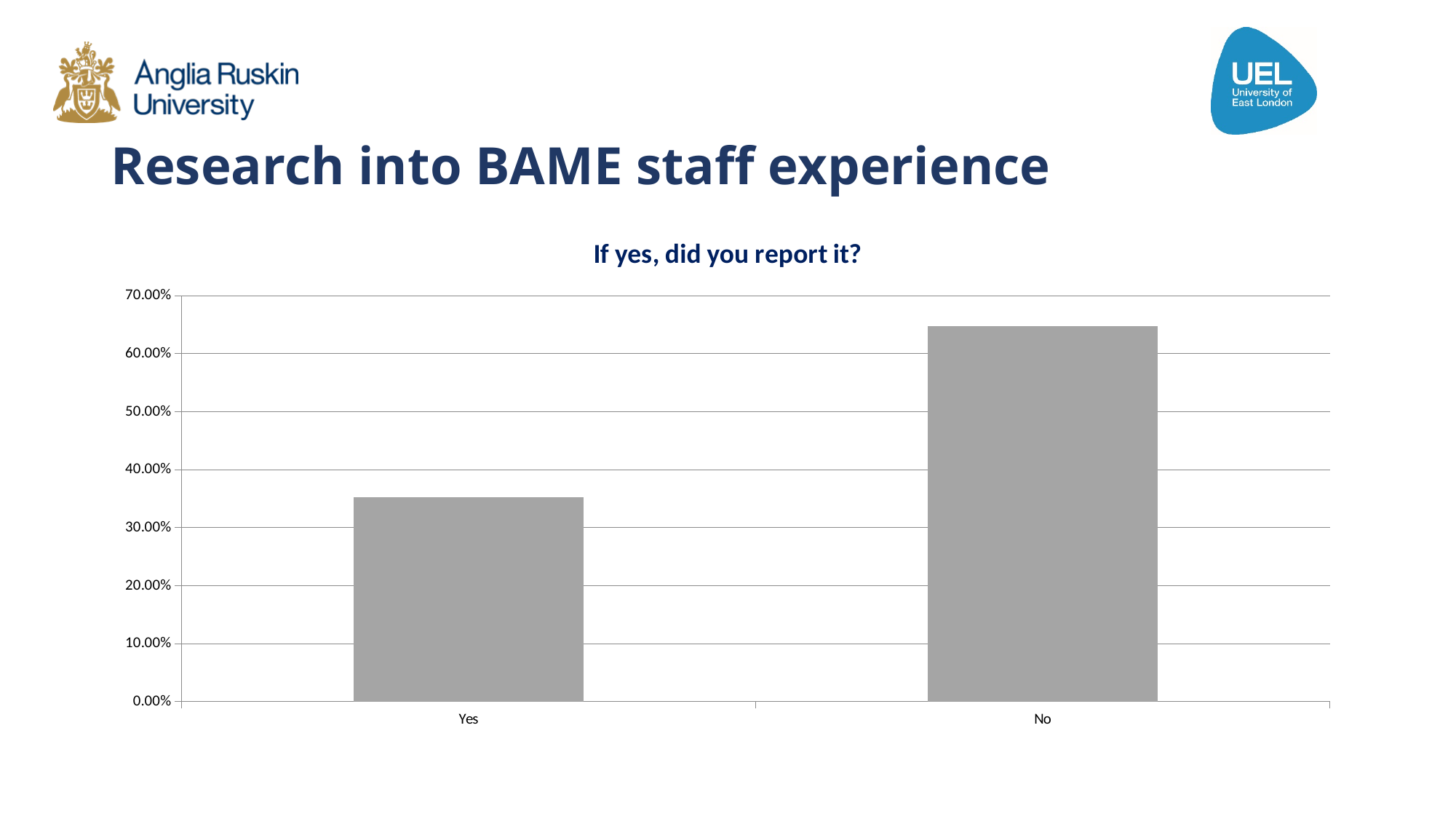
Is the value for Yes greater or less than 30.00%? greater Is the value for Yes greater or less than 40.00%? less Which category has the lowest value in the chart? Yes Is the value for No greater or less than 70.00%? less What is the highest value shown on the y axis of the chart? 70.00% Which is larger, the value for Yes or the value for No? No Which category has the highest value in the chart? No What is the title of the chart? If yes, did you report it? What kind of chart is shown on the slide? bar chart How many categories are shown on the x axis of the chart? 2